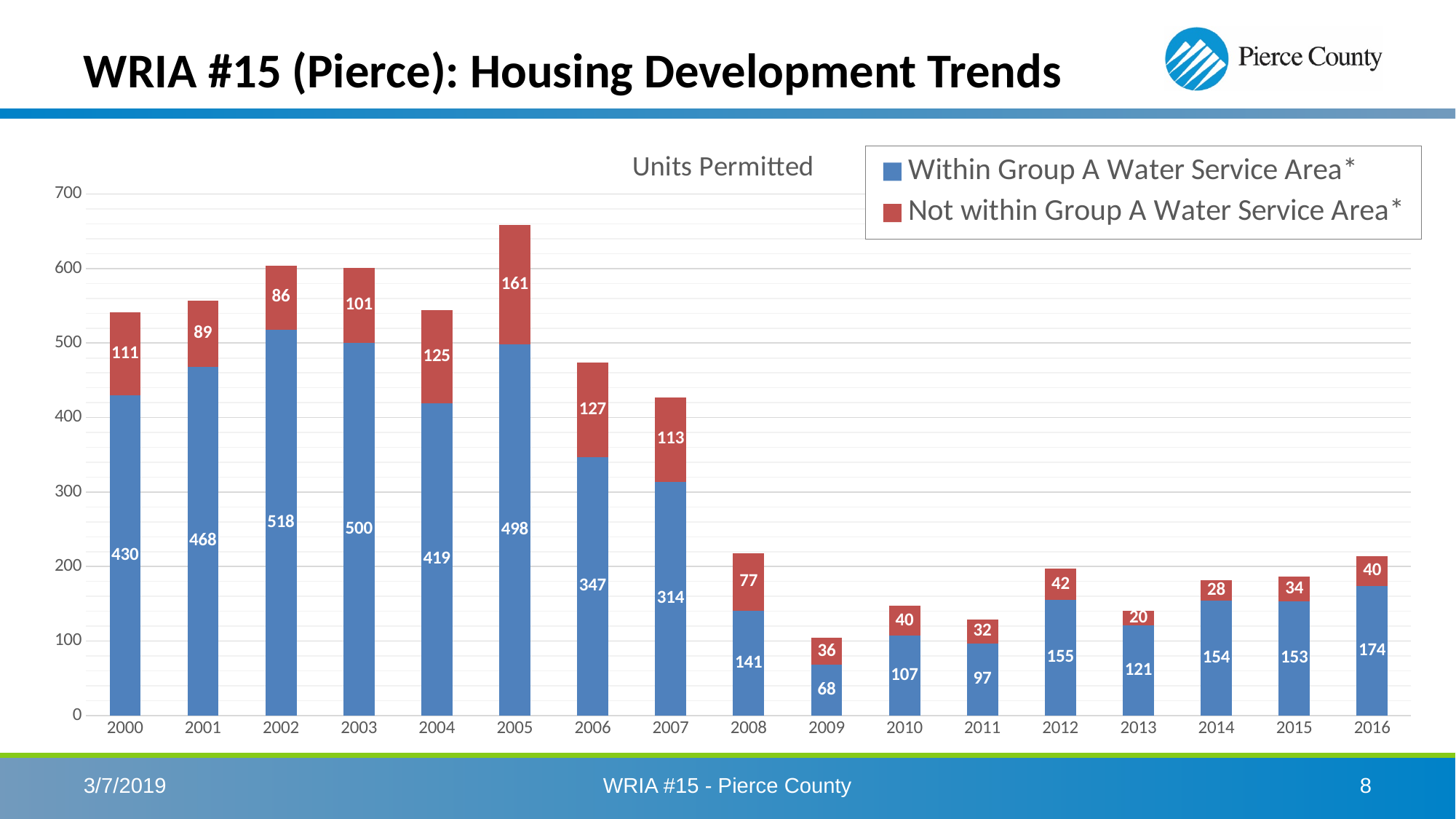
How many series does the legend list? 2 Which year has the highest value for Not within Group A Water Service Area? 2005 What is the value for Within Group A Water Service Area in 2003? 500 Which year has the lowest value for Within Group A Water Service Area? 2009 How many years are shown on the x axis? 17 What is the total of the stacked bar for 2005? 659 What type of chart is shown on the slide? stacked bar chart What is the difference between the Within Group A Water Service Area values for 2002 and 2003? 18 Which year has the highest value for Within Group A Water Service Area? 2002 Do the Within Group A Water Service Area values rise or fall from 2005 to 2009? fall What is the value for Not within Group A Water Service Area in 2006? 127 Which is larger, the Within Group A Water Service Area value for 2006 or for 2007? 2006